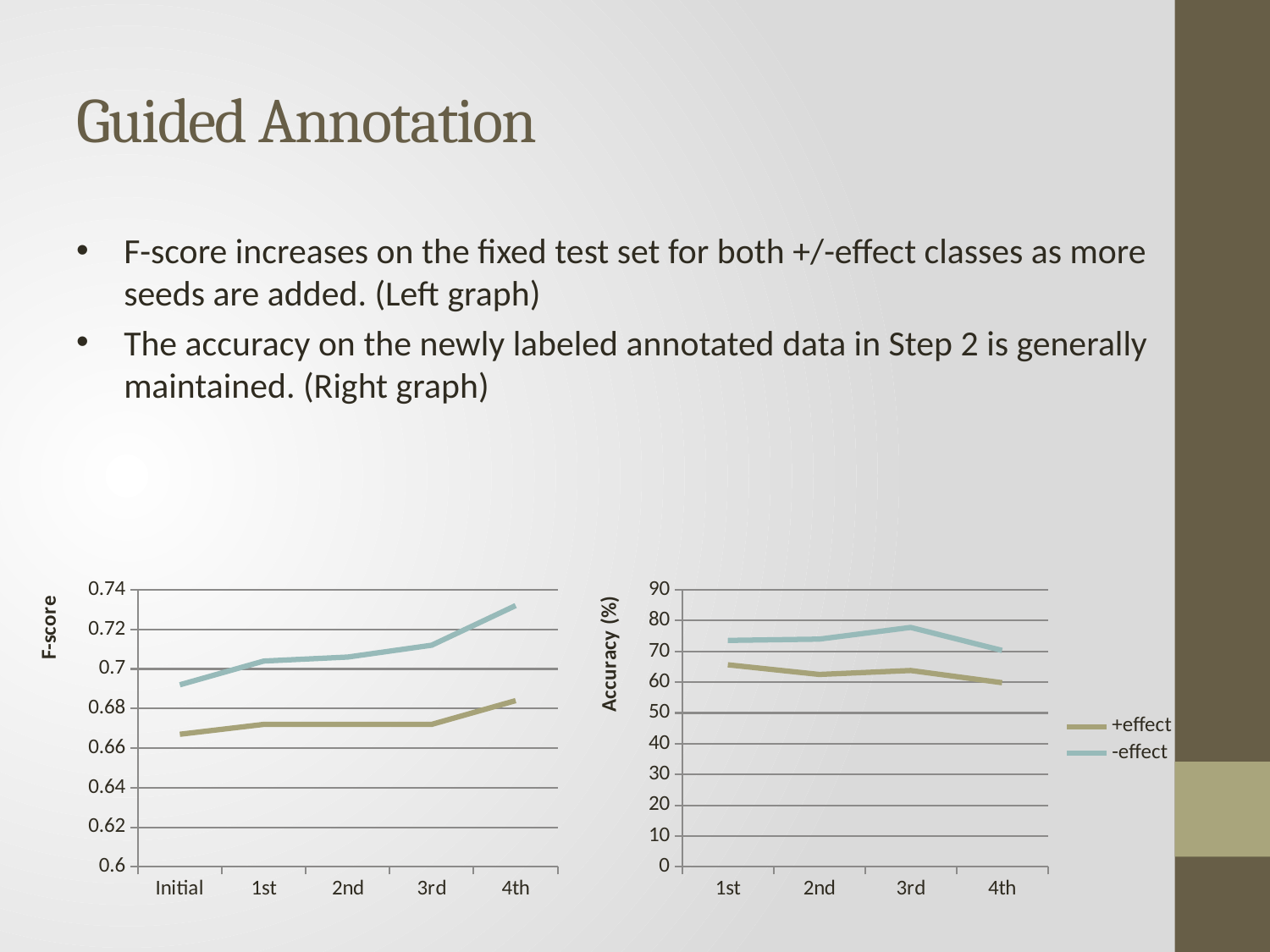
In the right chart (Accuracy (%)), which series has the larger value at 1st, +effect or -effect? -effect In the left chart (F-score), is the +effect value at Initial greater or less than 0.68? less How many categories are on the x axis of the right chart (Accuracy (%))? 4 What is the y-axis label of the right chart? Accuracy (%) In the right chart (Accuracy (%)), is the +effect value at 4th greater or less than 70? less In the right chart (Accuracy (%)), at which category is the -effect value highest? 3rd How many categories are on the x axis of the left chart (F-score)? 5 In the left chart (F-score), at which category is the +effect value lowest? Initial In the left chart (F-score), is the -effect value at 4th greater or less than 0.72? greater What kind of chart is the left chart (F-score)? line chart How many series does the legend list? 2 In the left chart (F-score), does the -effect line rise or fall from Initial to 4th? rise